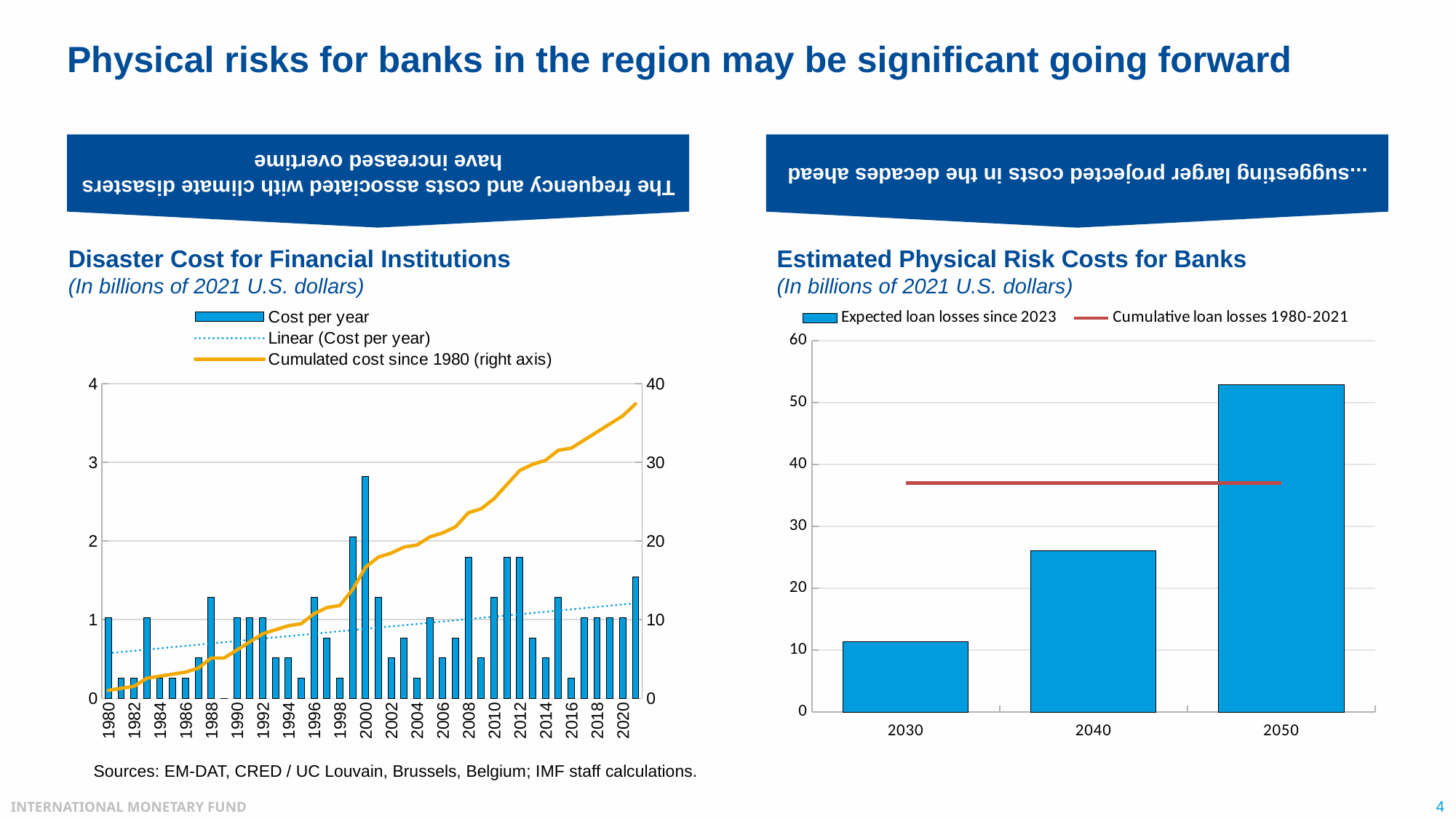
In the 'Disaster Cost for Financial Institutions' chart, how many entries does the legend list? 3 In the 'Estimated Physical Risk Costs for Banks' chart, do the expected loan losses rise or fall from 2030 to 2050? rise In the 'Estimated Physical Risk Costs for Banks' chart, which year has the lowest expected loan losses? 2030 In the 'Estimated Physical Risk Costs for Banks' chart, is the expected loan losses value for 2030 greater or less than 20? less In the 'Estimated Physical Risk Costs for Banks' chart, which year has the highest expected loan losses? 2050 In the 'Estimated Physical Risk Costs for Banks' chart, is the expected loan losses bar for 2040 larger or smaller than the bar for 2030? larger In the 'Estimated Physical Risk Costs for Banks' chart, is the expected loan losses value for 2050 greater or less than 40? greater In the 'Disaster Cost for Financial Institutions' chart, is the cumulated cost since 1980 at the end of the series (2021) greater or less than 30 on the right axis? greater In the 'Estimated Physical Risk Costs for Banks' chart, how many entries does the legend list? 2 In the 'Estimated Physical Risk Costs for Banks' chart, how many years are shown on the x axis? 3 What kind of chart is the 'Estimated Physical Risk Costs for Banks' chart? bar chart In the 'Disaster Cost for Financial Institutions' chart, which year has the highest cost per year? 2000